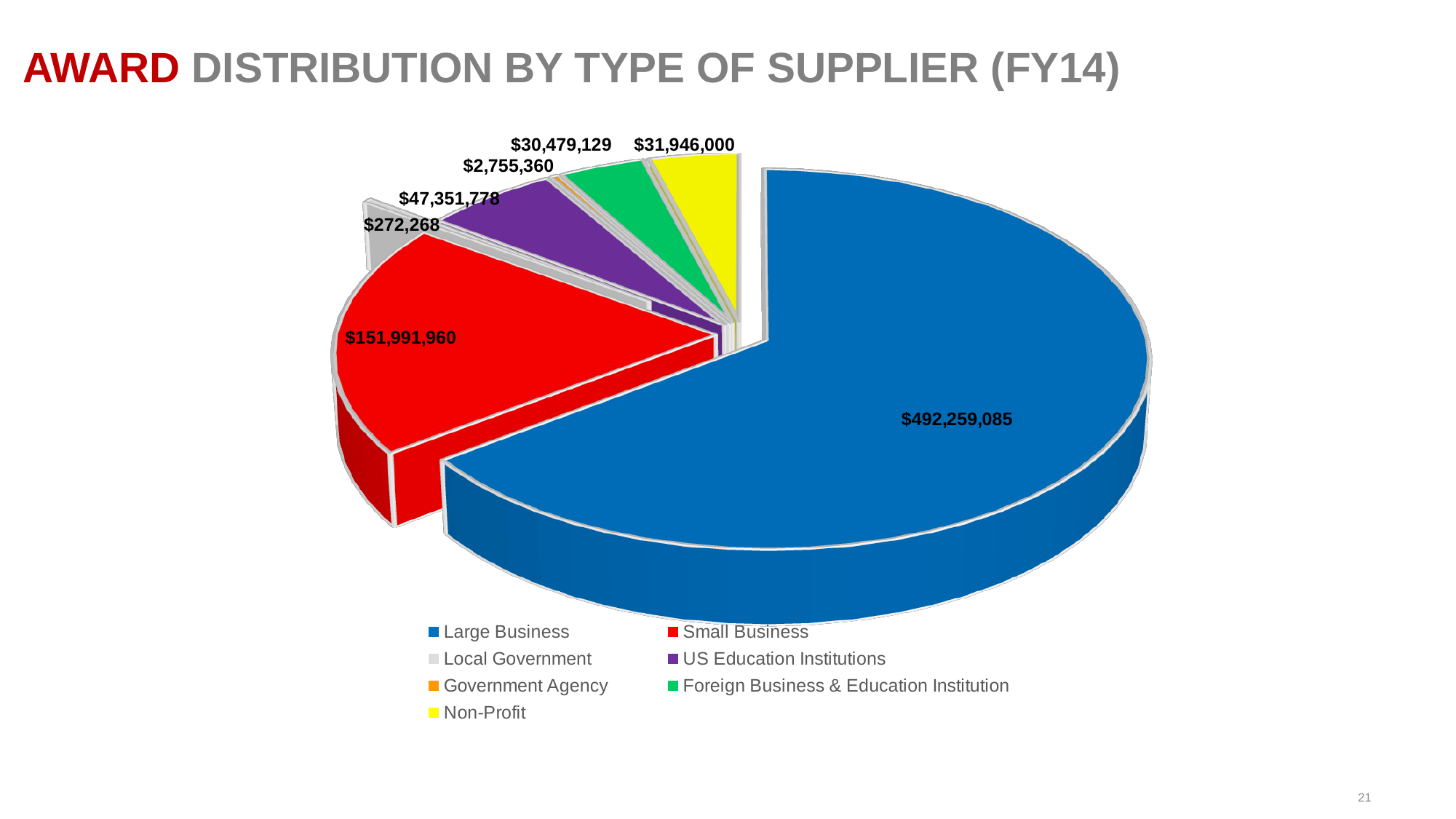
What colour represents Small Business in the chart? Red Which type of supplier received the largest award amount? Large Business Which received a larger award amount: Non-Profit or Foreign Business & Education Institution? Non-Profit What is the award value for Small Business? $151,991,960 What is the award value for Government Agency? $2,755,360 What is the difference between the award values for Large Business and Small Business? $340,267,125 How many supplier types are shown in the pie chart? 7 What is the award value for Non-Profit? $31,946,000 What is the award value for US Education Institutions? $47,351,778 What type of chart is shown on the slide? Pie chart Which type of supplier received the smallest award amount? Local Government What is the award value for Large Business? $492,259,085